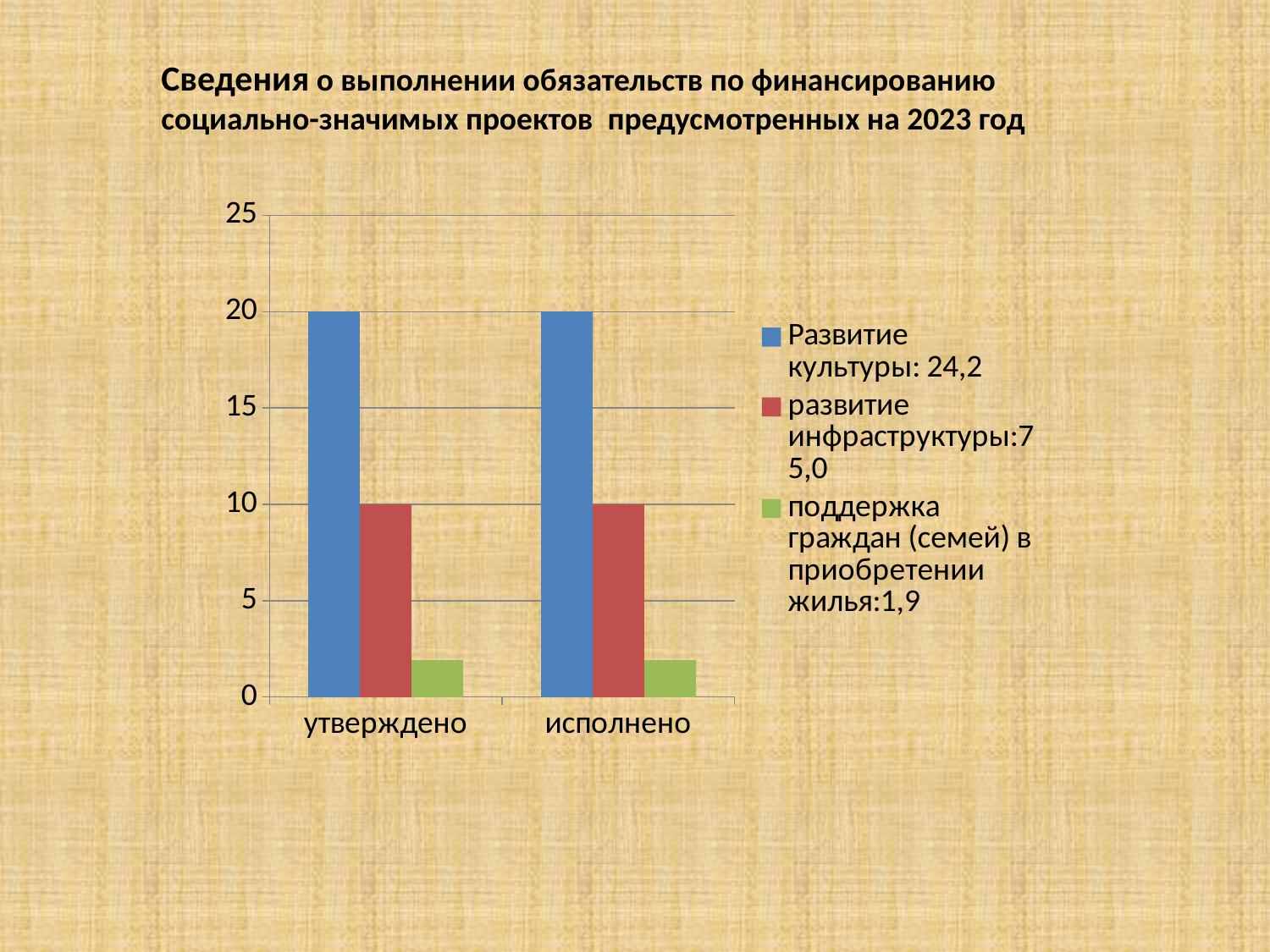
Which series has the lowest bar in the 'утверждено' category? поддержка граждан (семей) в приобретении жилья Do the 'Развитие культуры' bars rise, fall or stay the same from 'утверждено' to 'исполнено'? stay the same What is the value of the 'развитие инфраструктуры' bar for 'исполнено'? 10 What kind of chart is shown on the slide? bar chart How many series does the legend list? 3 Which colour represents the 'развитие инфраструктуры' series in the legend? red What is the value of the 'Развитие культуры' bar for 'утверждено'? 20 What is the difference between the 'Развитие культуры' bar and the 'развитие инфраструктуры' bar for 'утверждено'? 10 Which series has the highest bar in the 'исполнено' category? Развитие культуры How many categories are shown on the x axis? 2 Which is larger for 'исполнено': the 'развитие инфраструктуры' bar or the 'поддержка граждан (семей) в приобретении жилья' bar? развитие инфраструктуры Is the value of the 'поддержка граждан (семей) в приобретении жилья' bar for 'утверждено' greater or less than 5? less